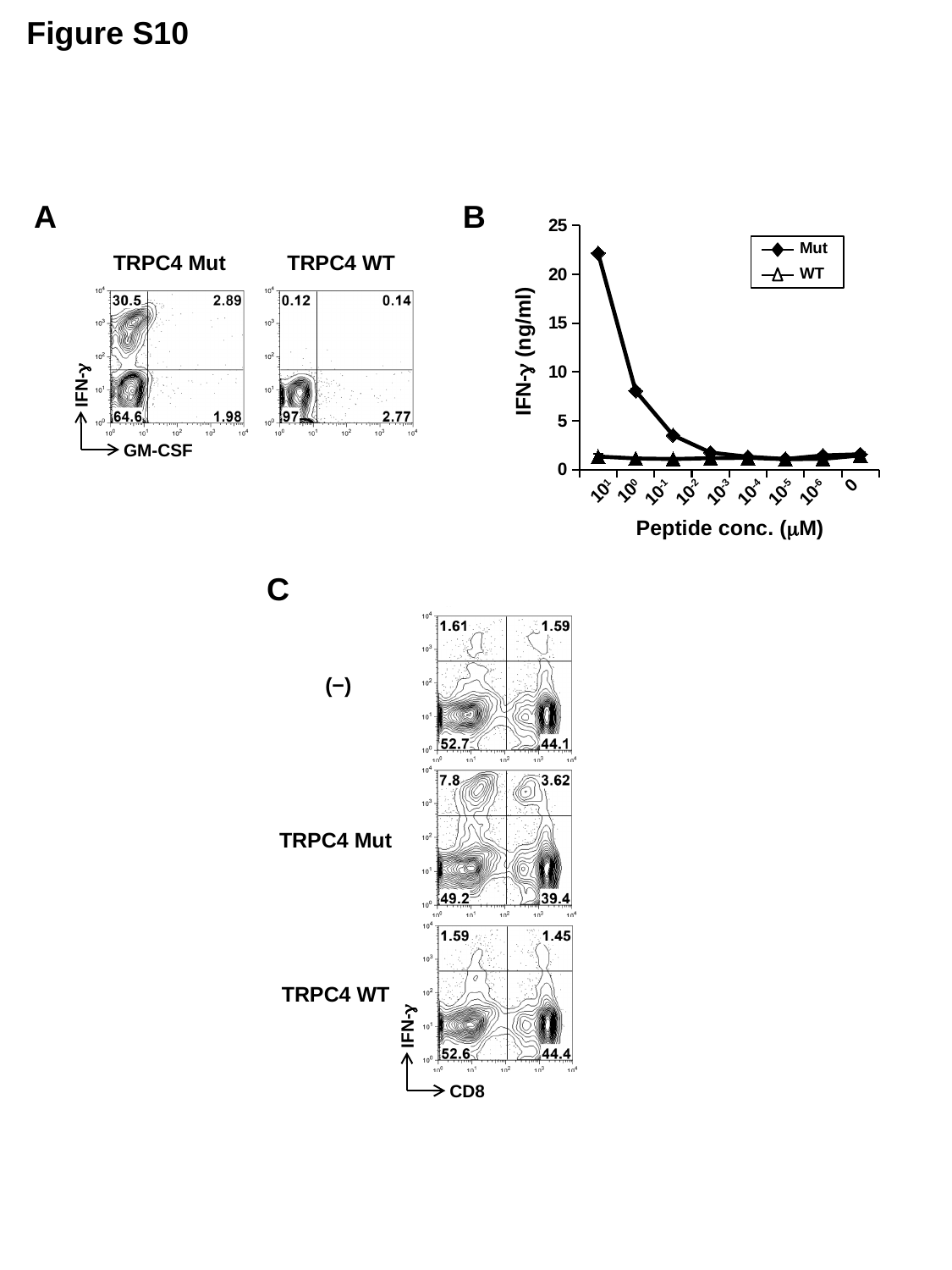
In panel B, is the WT value at peptide concentration 10^1 µM greater or less than 5 ng/ml? less In panel B, what kind of chart is shown? line chart In panel B, what is the y-axis label? IFN-γ (ng/ml) In panel B, which series is higher at peptide concentration 10^0 µM, Mut or WT? Mut In panel C, what percentage is shown in the upper-left quadrant of the TRPC4 Mut plot? 7.8 In panel B, does the Mut series rise or fall as peptide concentration decreases from 10^1 to 10^-2 µM? fall In panel C, what is the difference between the lower-right quadrant percentages of the (−) plot and the TRPC4 Mut plot? 4.7 In panel B, how many series does the legend list? 2 In panel B, how many peptide concentration points are plotted along the x axis? 9 In panel A, what percentage is shown in the upper-left quadrant of the TRPC4 Mut plot? 30.5 In panel B, is the Mut value at peptide concentration 10^1 µM greater or less than 20 ng/ml? greater In panel A, what percentage is shown in the lower-left quadrant of the TRPC4 WT plot? 97